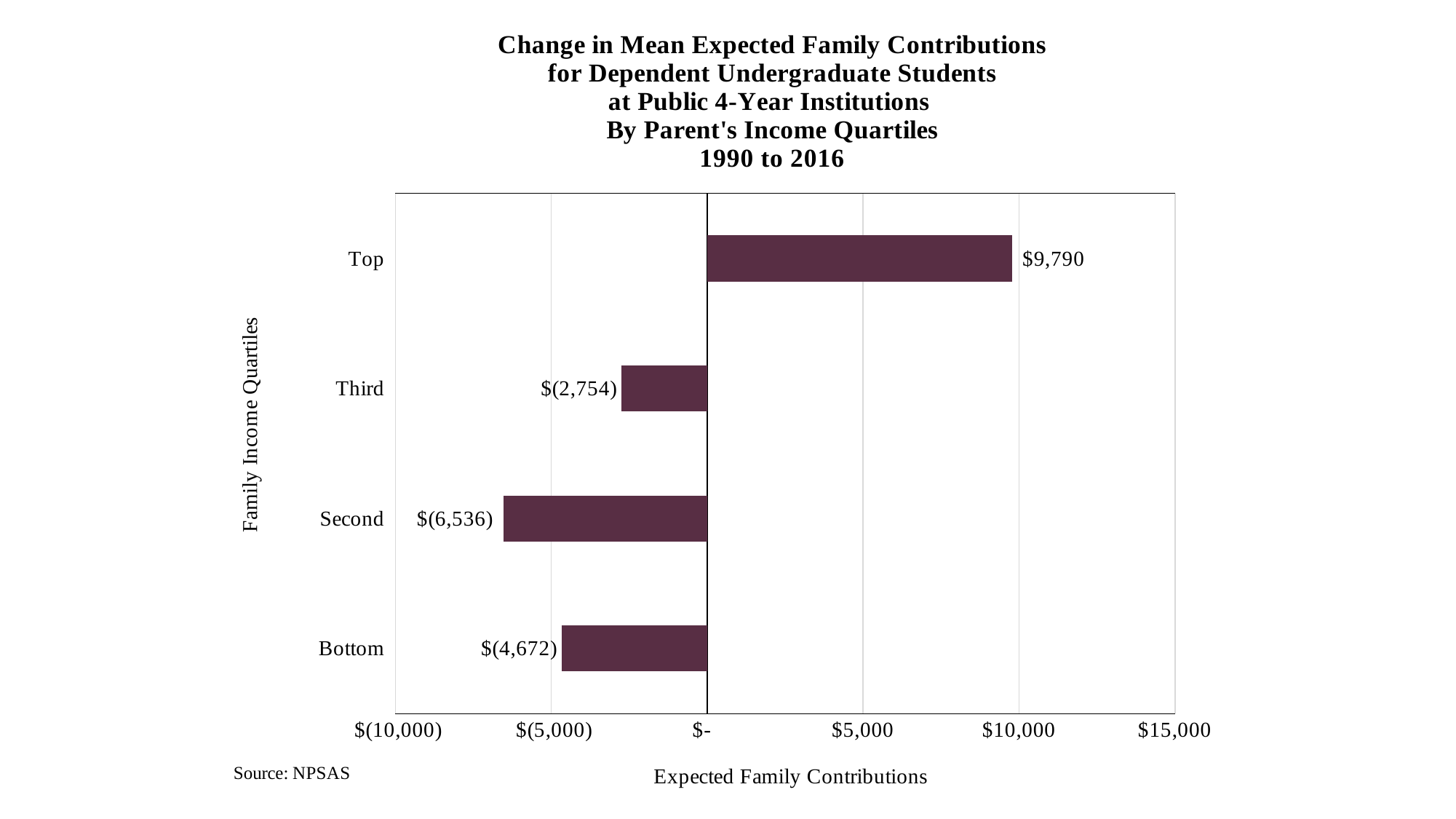
What kind of chart is shown on the slide? Bar chart How many income quartiles are shown on the chart? 4 What is the difference between the Top quartile's change and the Second quartile's change in expected family contribution? $16,326 What is the change in mean expected family contribution for the Third income quartile? $(2,754) Which income quartile has the lowest (most negative) change in expected family contribution? Second What is the change in mean expected family contribution for the Top income quartile? $9,790 What is the change in mean expected family contribution for the Bottom income quartile? $(4,672) Is the value for the Top quartile greater or less than $5,000? greater What is the source cited for the chart data? NPSAS Which quartile has a larger decrease in expected family contribution, Bottom or Third? Bottom What is the change in mean expected family contribution for the Second income quartile? $(6,536) Which income quartile has the highest change in expected family contribution? Top